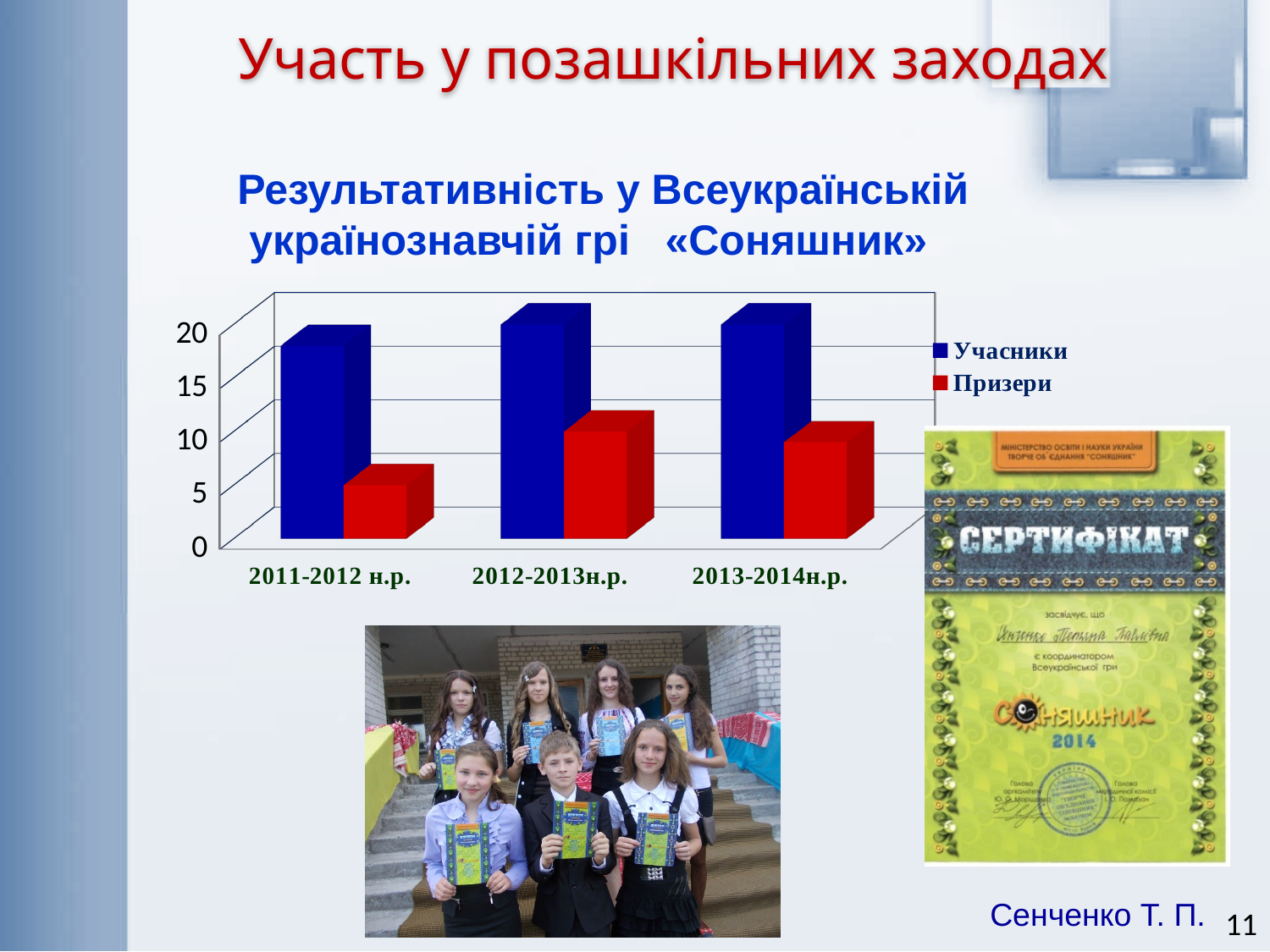
Which series is shown in blue in the chart? Учасники Is the value for Учасники in 2013-2014н.р. greater or less than 15? greater Is the value for Призери in 2012-2013н.р. greater or less than 5? greater In which school year is the Призери value lowest? 2011-2012 н.р. In 2012-2013н.р., which is larger: Учасники or Призери? Учасники What are the two legend entries of the chart? Учасники, Призери What kind of chart is shown on the slide? bar chart Which is larger: Призери in 2011-2012 н.р. or Призери in 2012-2013н.р.? Призери in 2012-2013н.р. Is the value for Призери in 2011-2012 н.р. greater or less than 10? less How many school years (categories) are shown on the x axis of the chart? 3 How many series does the chart legend list? 2